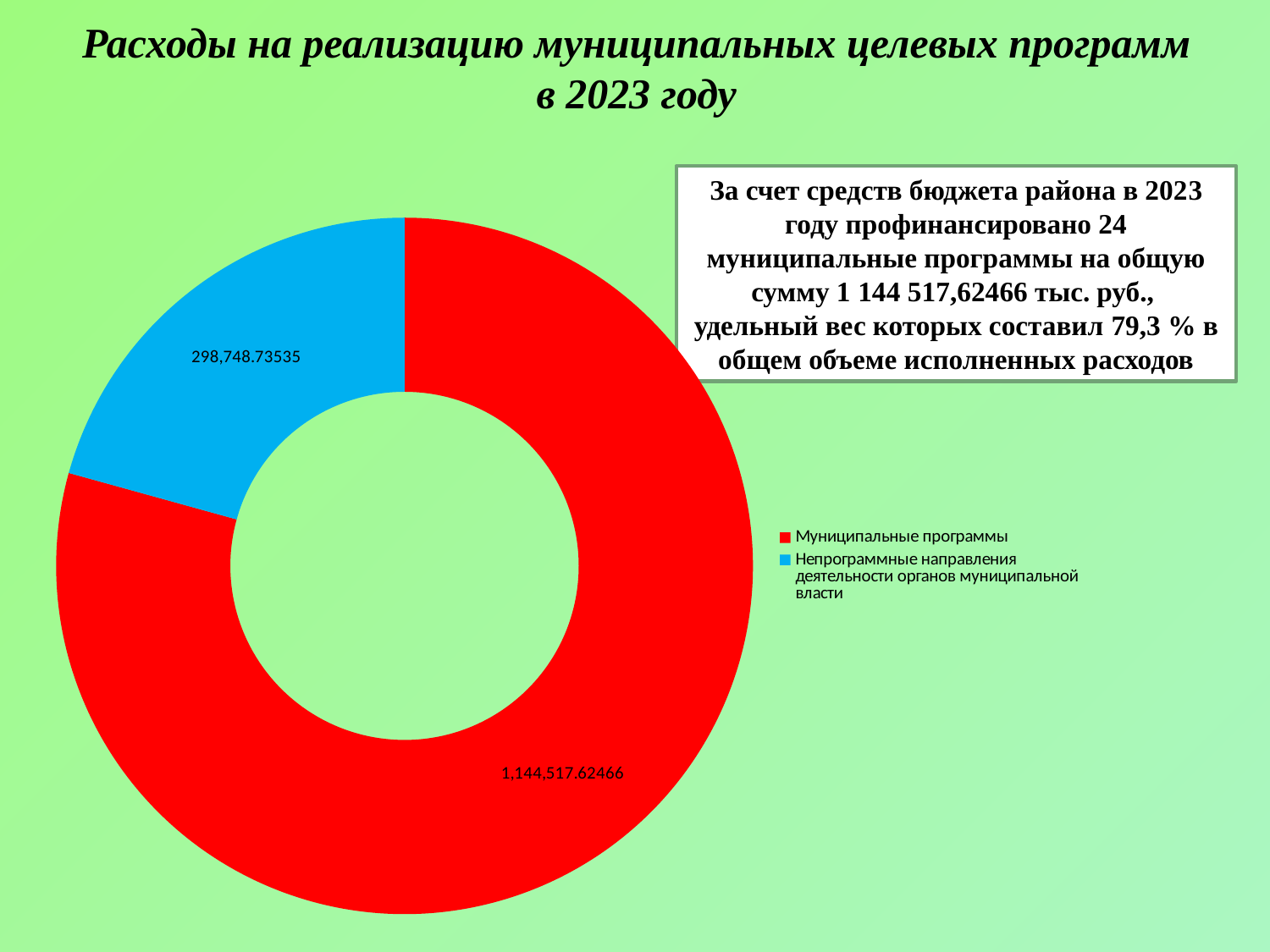
What is the difference between the value for Муниципальные программы and the value for Непрограммные направления деятельности органов муниципальной власти? 845,768.88931 Which is larger: the value for Муниципальные программы or the value for Непрограммные направления деятельности органов муниципальной власти? Муниципальные программы What kind of chart is shown on the slide? Doughnut (pie) chart What share of the whole does the Муниципальные программы slice represent, to one decimal place? 79.3% What is the total of the two values shown on the chart? 1,443,266.36001 What is the value shown for Непрограммные направления деятельности органов муниципальной власти? 298,748.73535 Which category has the smallest slice of the chart? Непрограммные направления деятельности органов муниципальной власти What is the value shown for Муниципальные программы? 1,144,517.62466 What colour is the slice for Непрограммные направления деятельности органов муниципальной власти? Blue How many categories does the chart show? 2 How many entries does the legend list? 2 Which category has the largest slice of the chart? Муниципальные программы